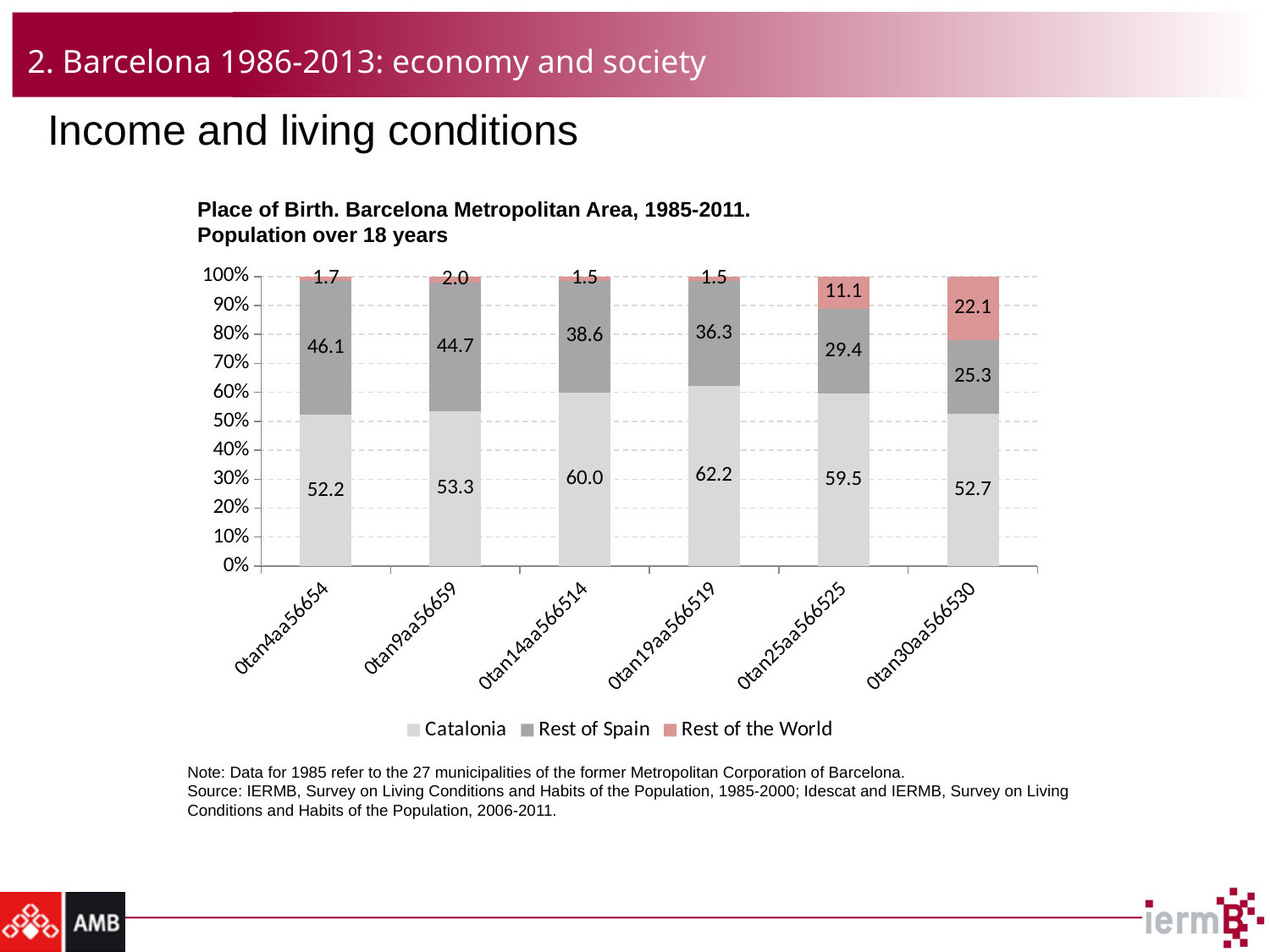
What kind of chart is shown on the slide? Stacked bar chart Which bar has the lowest Rest of Spain value? The last (rightmost) bar (25.3) What is the difference between the Rest of the World value in the last bar and in the fifth bar? 11.0 What is the Catalonia value for the first (leftmost) bar? 52.2 What is the Rest of the World value for the last (rightmost) bar? 22.1 Does the Rest of Spain value rise or fall from the first bar to the last bar? Fall How many stacked bars are shown in the chart? 6 Which bar has the highest Catalonia value? The fourth bar from the left (62.2) How many series does the legend list? 3 What is the Rest of Spain value for the fifth bar from the left? 29.4 Which is larger, the Catalonia value in the third bar or in the fifth bar? The third bar (60.0) What is the difference between the Rest of Spain value in the first bar and in the last bar? 20.8